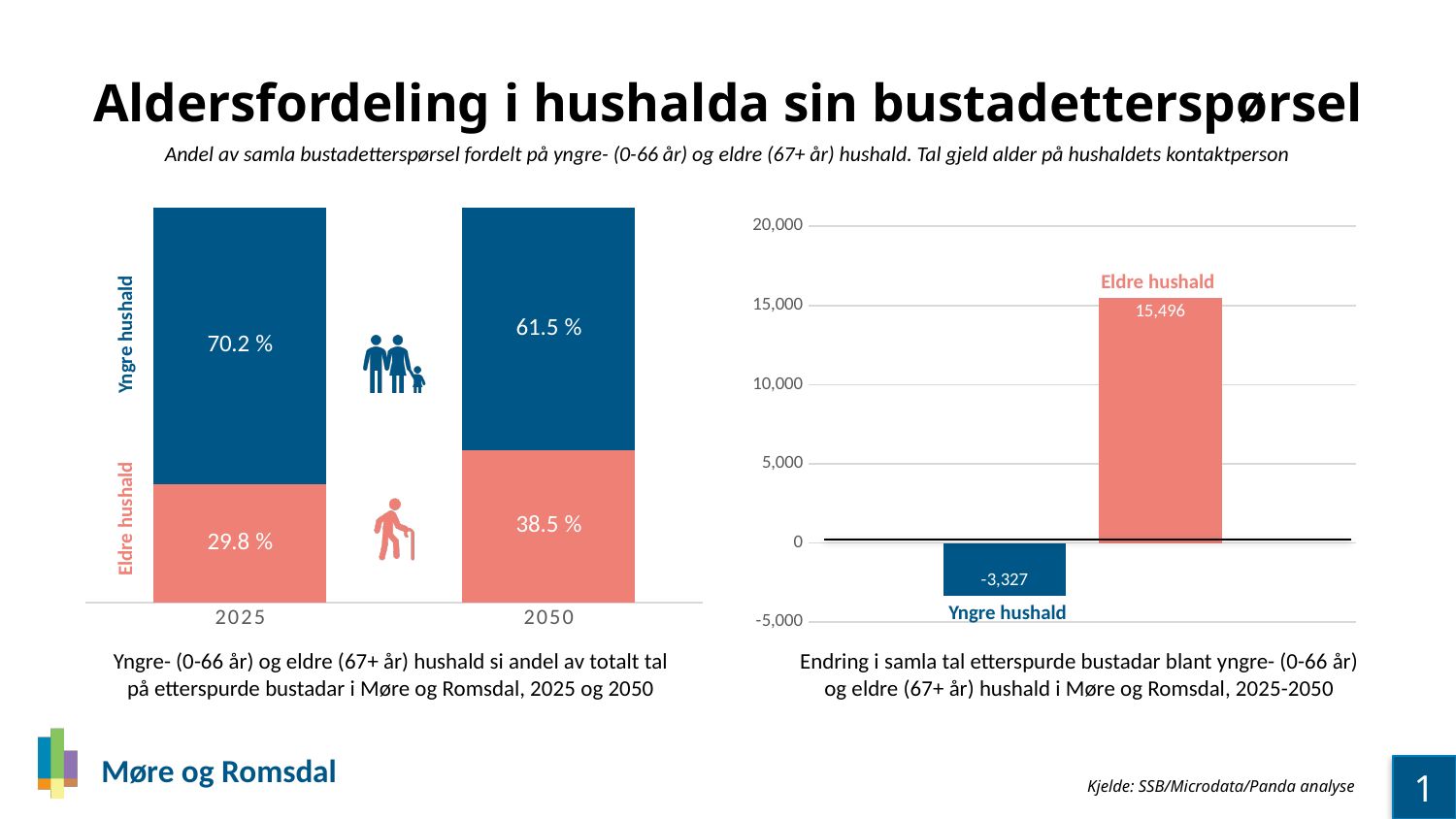
In the right chart, which household group has the larger change in demanded dwellings? Eldre hushald In the right chart, what is the difference between the Eldre hushald and Yngre hushald values? 18,823 In the left chart, what is the share for Eldre hushald in 2025? 29.8 % In the left chart, does the share of Eldre hushald rise or fall from 2025 to 2050? rise In the left chart, by how many percentage points does the Yngre hushald share fall from 2025 to 2050? 8.7 percentage points What kind of chart is the left chart? stacked bar chart In the right chart, what is the change in demanded dwellings for Yngre hushald, 2025-2050? -3,327 In the left chart, what share of housing demand do Yngre hushald account for in 2025? 70.2 % In the right chart, is the value for Eldre hushald greater or less than 15,000? greater In the left chart, what share of housing demand do Eldre hushald account for in 2050? 38.5 % In the left chart, how many years (categories) are shown on the x axis? 2 In the right chart, what is the change in demanded dwellings for Eldre hushald, 2025-2050? 15,496